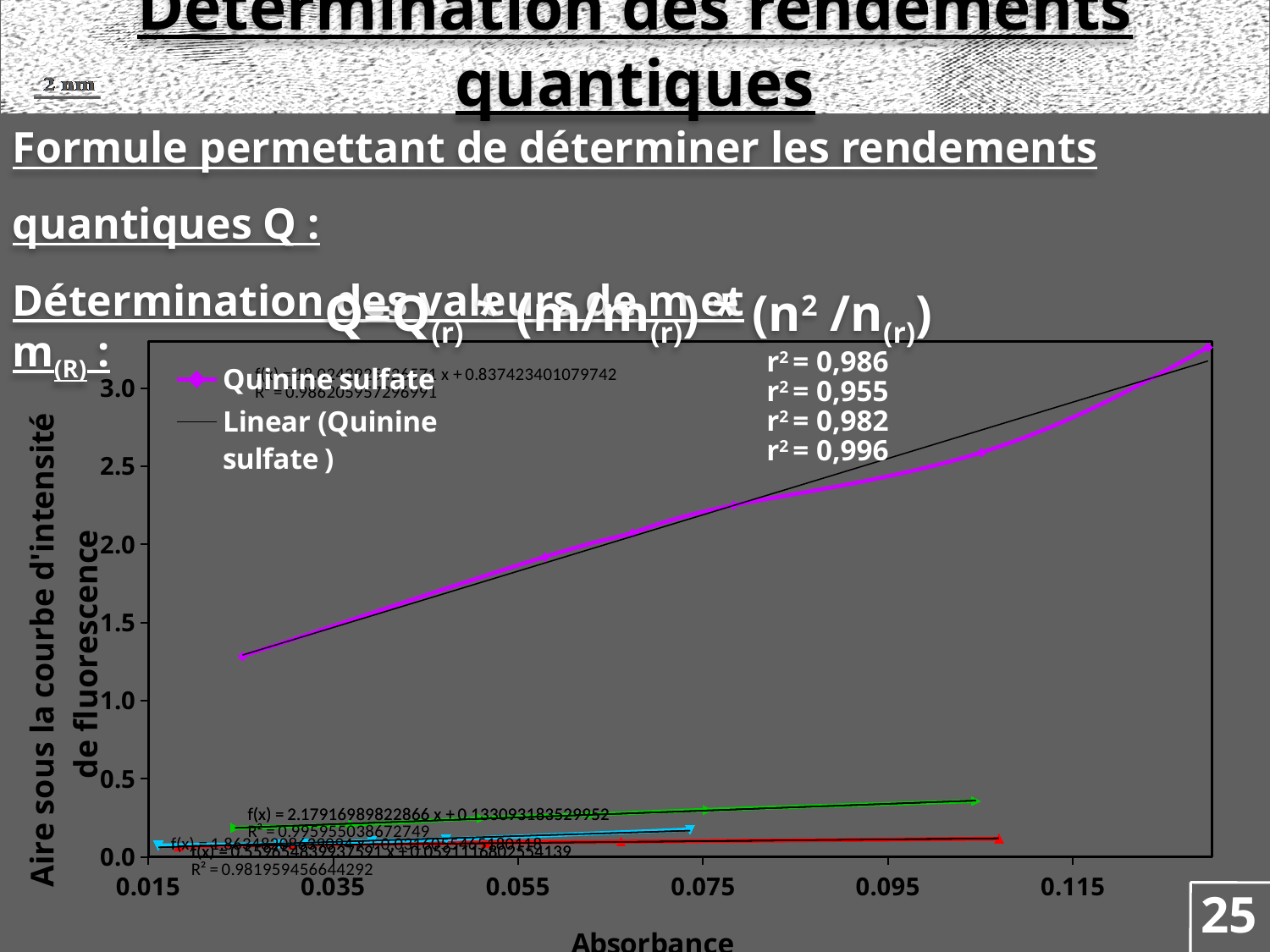
Does the Quinine sulfate series rise or fall as absorbance increases? rise What kind of chart is shown on the slide? line chart Which plotted series reaches the highest values on the chart? Quinine sulfate Is the value of the red series at an absorbance of 0.105 greater or less than 0.5? less What is the name of the data series listed first in the legend? Quinine sulfate Is the value of the green series at an absorbance of 0.095 greater or less than 0.5? less At an absorbance of 0.075, which series has the larger value, the purple Quinine sulfate series or the green series? Quinine sulfate Is the value of the Quinine sulfate series at an absorbance of 0.115 greater or less than 2.5? greater How many entries does the chart legend list? 2 What is the title of the x axis? Absorbance How many coloured data series are plotted on the chart? 4